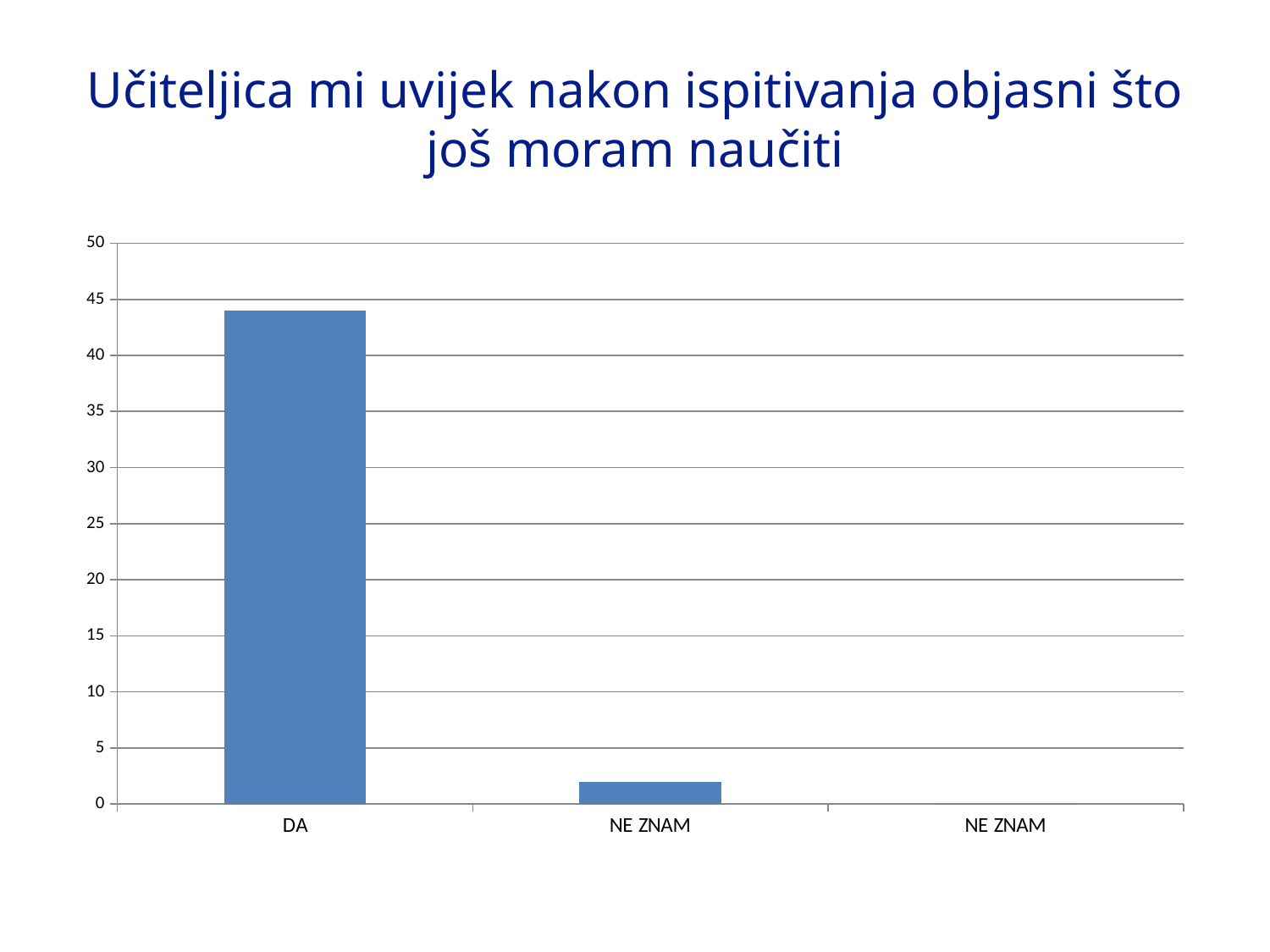
Is the value for DA greater or less than 40? greater Which is larger, the value for DA or the value for the middle category NE ZNAM? DA Which category has the highest value in the chart? DA What is the highest value shown on the y axis of the chart? 50 Is the value for the middle category (NE ZNAM) greater or less than 5? less Is the value for DA greater or less than 45? less What is the label of the first category on the x axis? DA What is the title of the chart on the slide? Učiteljica mi uvijek nakon ispitivanja objasni što još moram naučiti How many categories are shown on the x axis of the chart? 3 What kind of chart is shown on the slide? bar chart